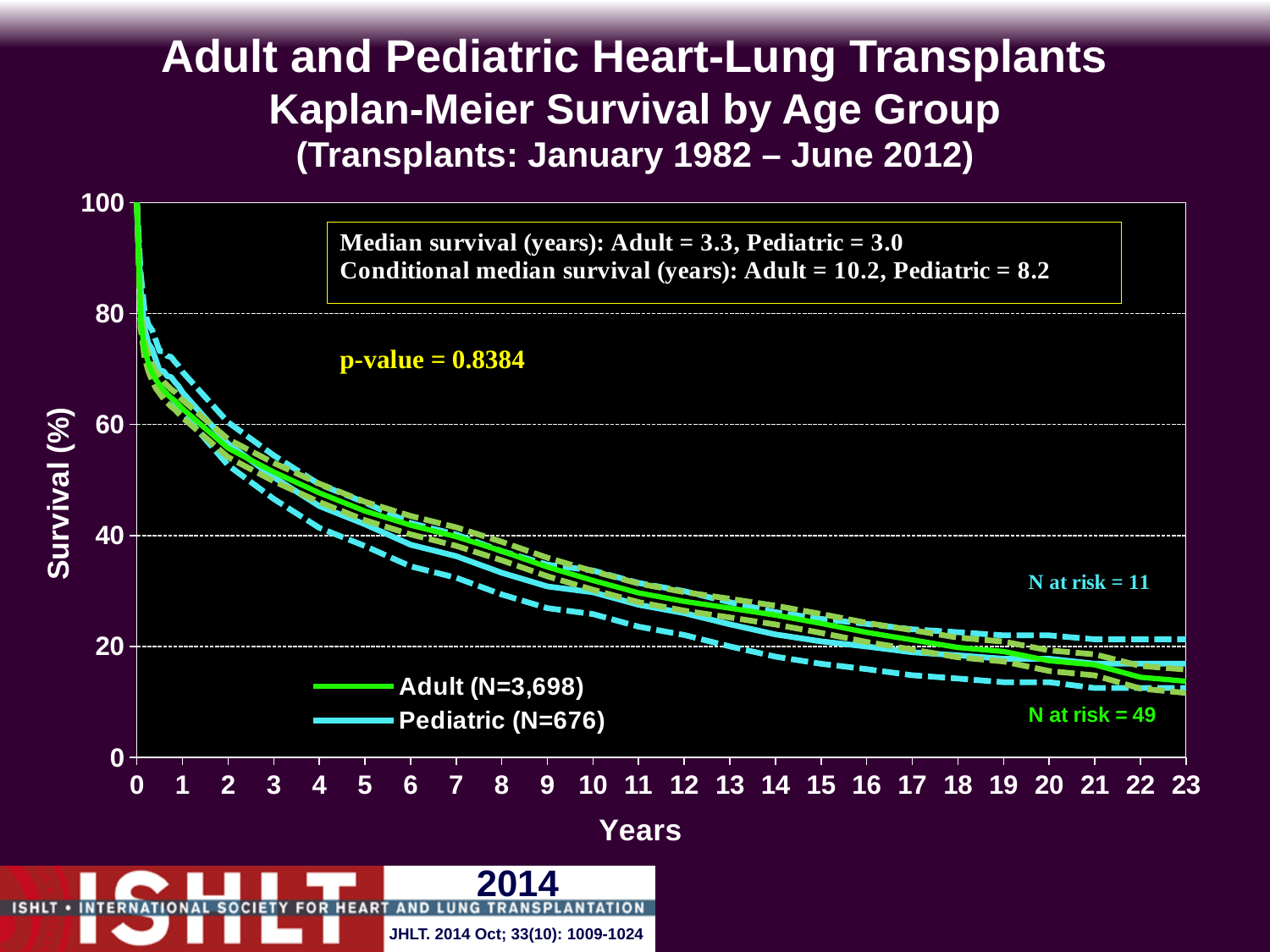
Is the Adult survival at 10 years greater or less than 40? less What is the difference between the Adult and Pediatric conditional median survival in years? 2.0 Do the survival curves rise or fall as years increase? Fall Is the Pediatric survival at 20 years greater or less than 20? less What kind of chart is shown on the slide? Line chart How many series does the legend list? 2 What is the p-value shown on the chart? 0.8384 What is the conditional median survival in years for the Adult group? 10.2 What is the median survival in years for the Pediatric group? 3.0 What is the median survival in years for the Adult group? 3.3 Which group has the higher median survival, Adult or Pediatric? Adult What is the N at risk for the Adult group at the end of the curve? 49